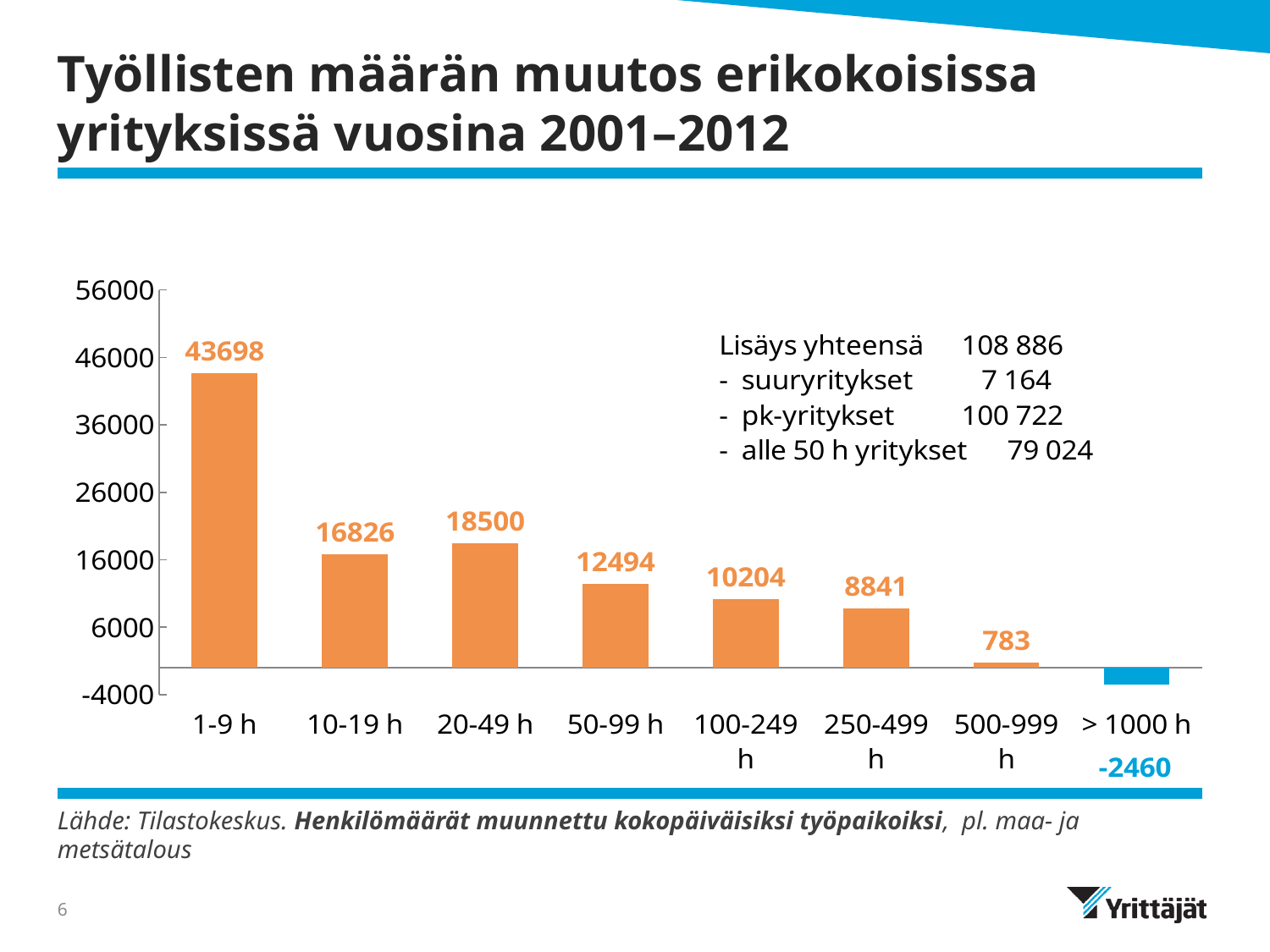
What is the value for the 20-49 h category? 18500 What is the value for the 1-9 h category? 43698 How many categories are shown on the x axis? 8 Is the value for 50-99 h greater or less than 16000? less What colour is the bar for the > 1000 h category? Blue What is the value for the 500-999 h category? 783 Which category has the lowest value? > 1000 h Which is larger, the value for 100-249 h or the value for 250-499 h? 100-249 h What is the difference between the values for 20-49 h and 10-19 h? 1674 Which category has the highest value? 1-9 h What kind of chart is shown on the slide? Bar chart What is the value for the > 1000 h category? -2460